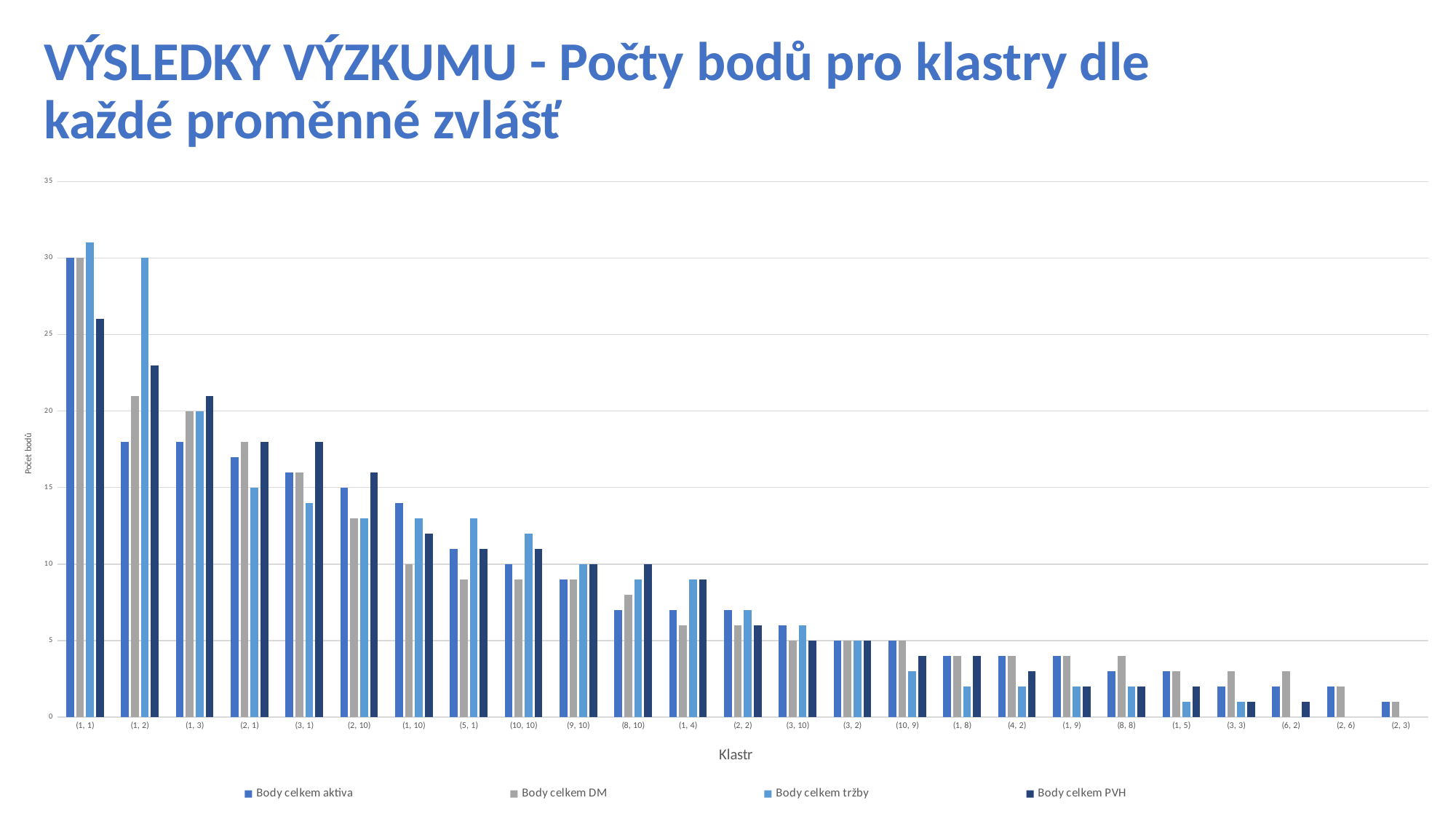
For cluster (1, 2), which is larger: Body celkem aktiva or Body celkem PVH? Body celkem PVH What is the value of Body celkem aktiva for cluster (1, 1)? 30 How many series does the legend list? 4 How many clusters (categories) are shown on the x axis? 25 What is the value of Body celkem tržby for cluster (1, 2)? 30 Is the value of Body celkem tržby for cluster (3, 1) greater or less than 15? less What kind of chart is shown on the slide? bar chart Which series has the highest value for cluster (1, 1)? Body celkem tržby What is the value of Body celkem PVH for cluster (3, 2)? 5 Do the values generally rise or fall moving from left to right along the x axis? fall What is the value of Body celkem DM for cluster (1, 3)? 20 Is the value of Body celkem PVH for cluster (1, 2) greater or less than 20? greater